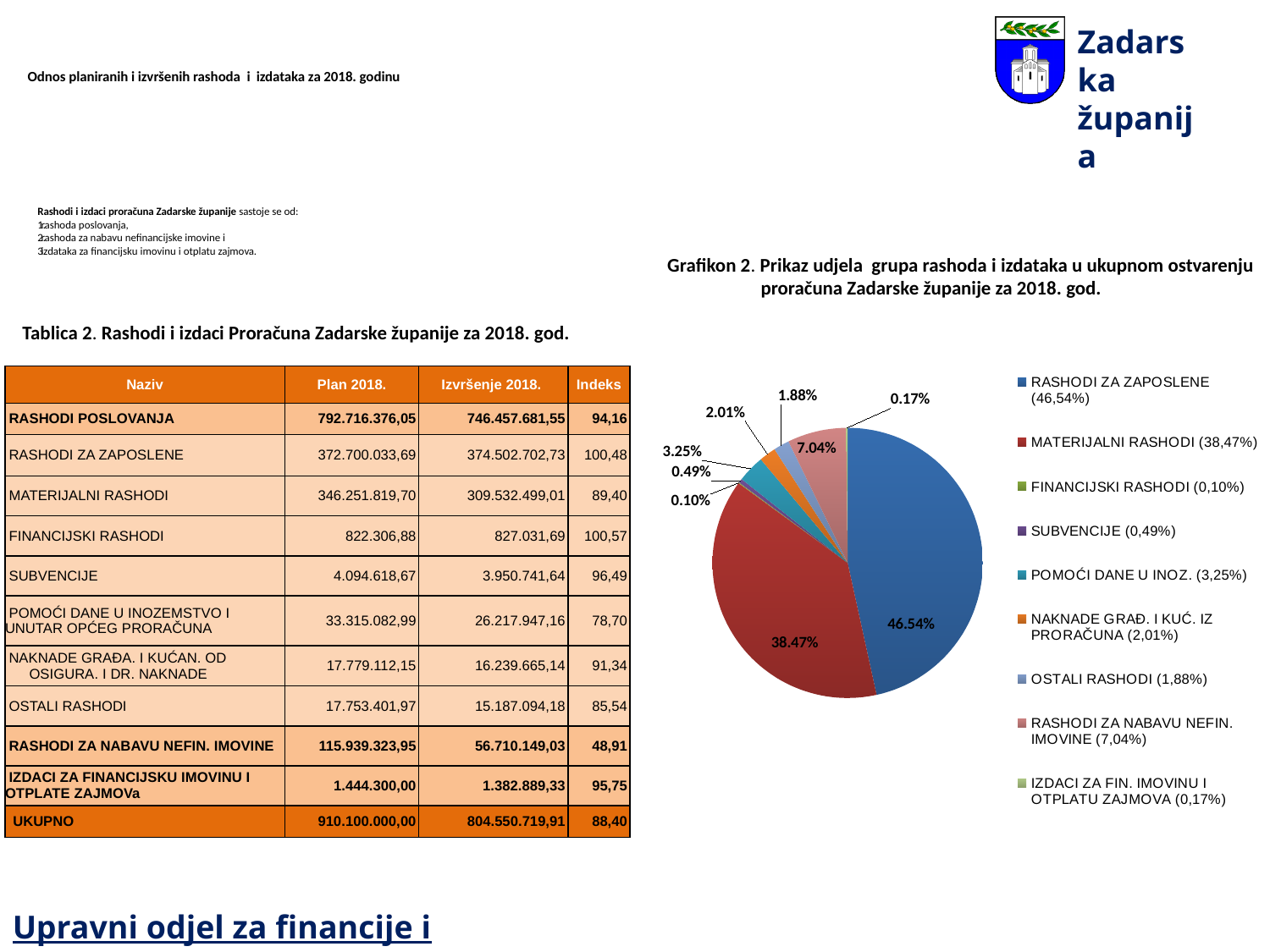
Which category has the largest slice in the pie chart? RASHODI ZA ZAPOSLENE What kind of chart is shown on the slide? Pie chart Which slice is larger in the pie chart: NAKNADE GRAĐ. I KUĆ. IZ PRORAČUNA or OSTALI RASHODI? NAKNADE GRAĐ. I KUĆ. IZ PRORAČUNA What share of the pie chart does MATERIJALNI RASHODI represent? 38.47% What share of the pie chart does OSTALI RASHODI represent? 1.88% What share of the pie chart does RASHODI ZA NABAVU NEFIN. IMOVINE represent? 7.04% What is the difference in percentage points between the RASHODI ZA ZAPOSLENE slice and the MATERIJALNI RASHODI slice? 8.07 What is the title of the pie chart? Grafikon 2. Prikaz udjela grupa rashoda i izdataka u ukupnom ostvarenju proračuna Zadarske županije za 2018. god. How many slices does the pie chart have? 9 Which category has the smallest slice in the pie chart? FINANCIJSKI RASHODI Which slice is larger in the pie chart: SUBVENCIJE or POMOĆI DANE U INOZ.? POMOĆI DANE U INOZ.